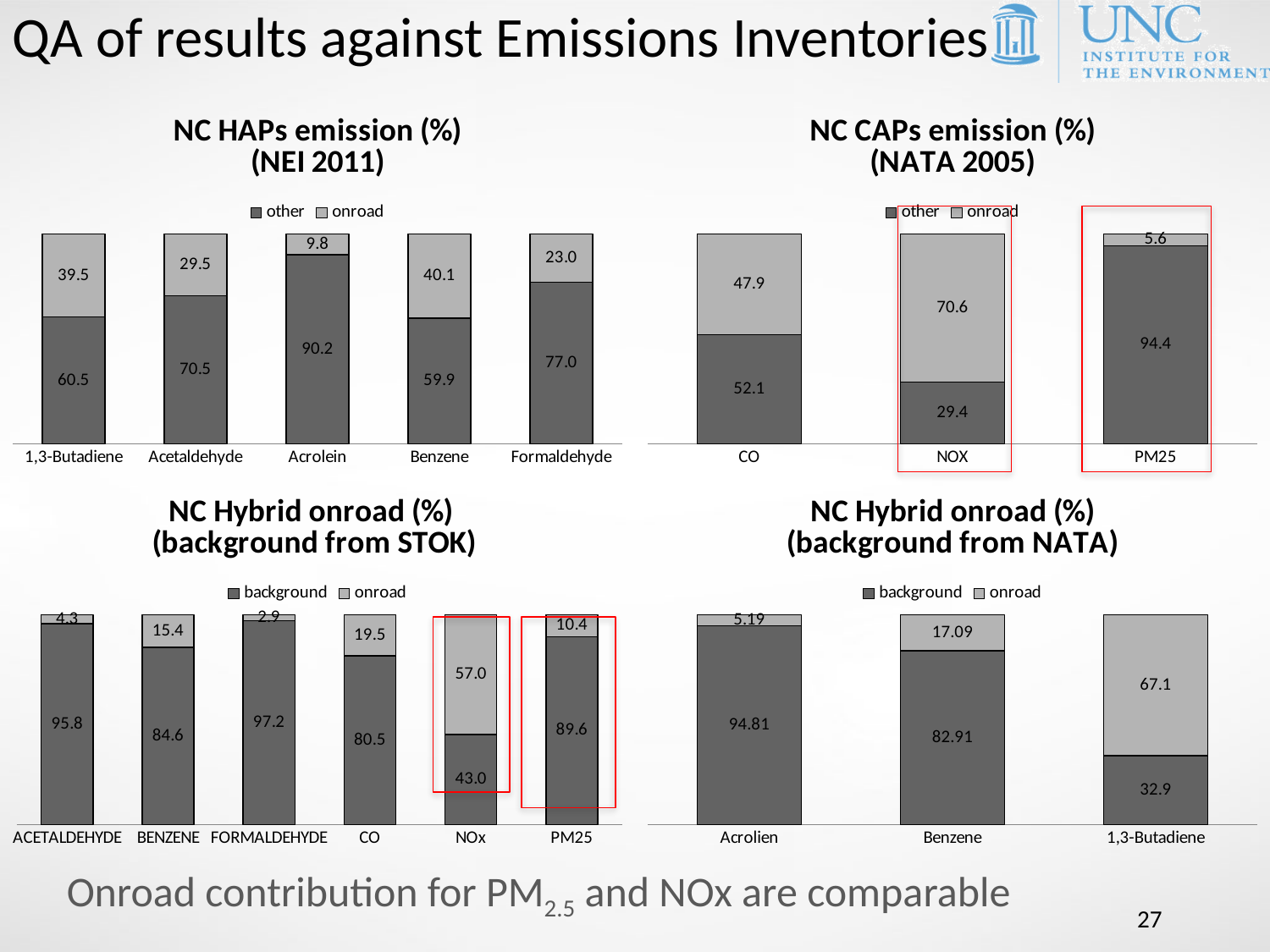
In the NC HAPs emission (%) (NEI 2011) chart, how many categories are shown on the x axis? 5 How many series does the legend list in the NC Hybrid onroad (%) (background from NATA) chart? 2 In the NC Hybrid onroad (%) (background from STOK) chart, what is the background value for CO? 80.5 In the NC HAPs emission (%) (NEI 2011) chart, which category has the highest onroad value? Benzene In the NC Hybrid onroad (%) (background from STOK) chart, which category has the highest onroad value? NOx In the NC CAPs emission (%) (NATA 2005) chart, which category has the lowest onroad value? PM25 In the NC Hybrid onroad (%) (background from NATA) chart, what is the onroad value for Benzene? 17.09 In the NC Hybrid onroad (%) (background from NATA) chart, is the background value for Acrolien larger or the background value for 1,3-Butadiene? Acrolien In the NC CAPs emission (%) (NATA 2005) chart, what is the difference between the 'other' value for PM25 and the 'other' value for CO? 42.3 In the NC Hybrid onroad (%) (background from STOK) chart, what is the total of the stacked bar for NOx? 100.0 In the NC HAPs emission (%) (NEI 2011) chart, what is the 'other' value for Acrolein? 90.2 In the NC CAPs emission (%) (NATA 2005) chart, what is the onroad value for NOX? 70.6